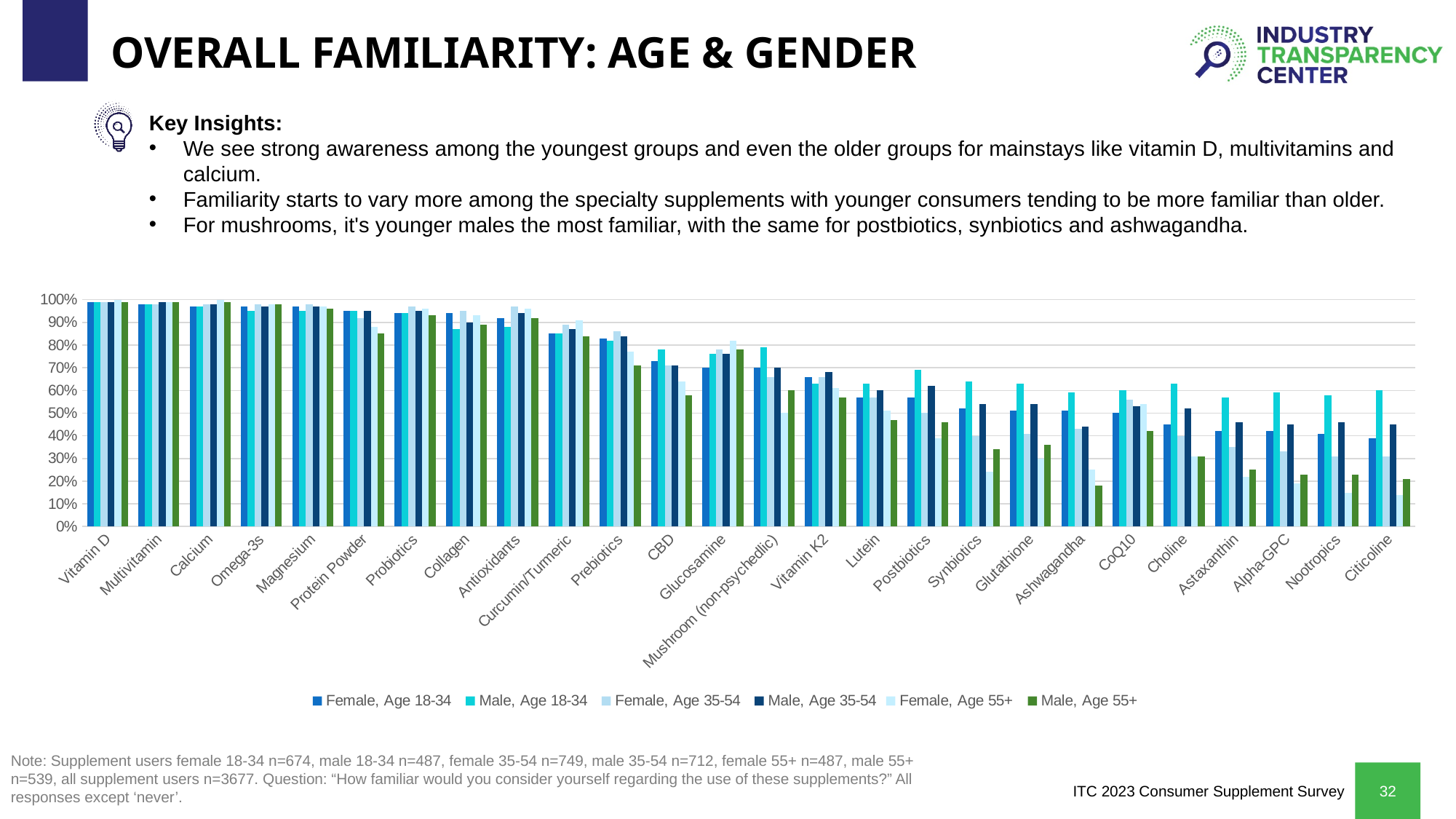
Is the value for Male, Age 55+ for CBD greater or less than 70%? less What kind of chart is shown on the slide? bar chart Is the value for Male, Age 55+ for Citicoline greater or less than 30%? less How many supplement categories are shown along the x axis of the chart? 26 For Mushroom (non-psychedlic), which series has the highest value? Male, Age 18-34 Do the values for Female, Age 18-34 generally rise or fall moving from left to right along the x axis? fall How many series does the chart legend list? 6 Which colour represents the Male, Age 55+ series in the chart? green For Citicoline, which is larger: the value for Male, Age 18-34 or the value for Male, Age 55+? Male, Age 18-34 Is the value for Male, Age 55+ for Protein Powder greater or less than 80%? greater